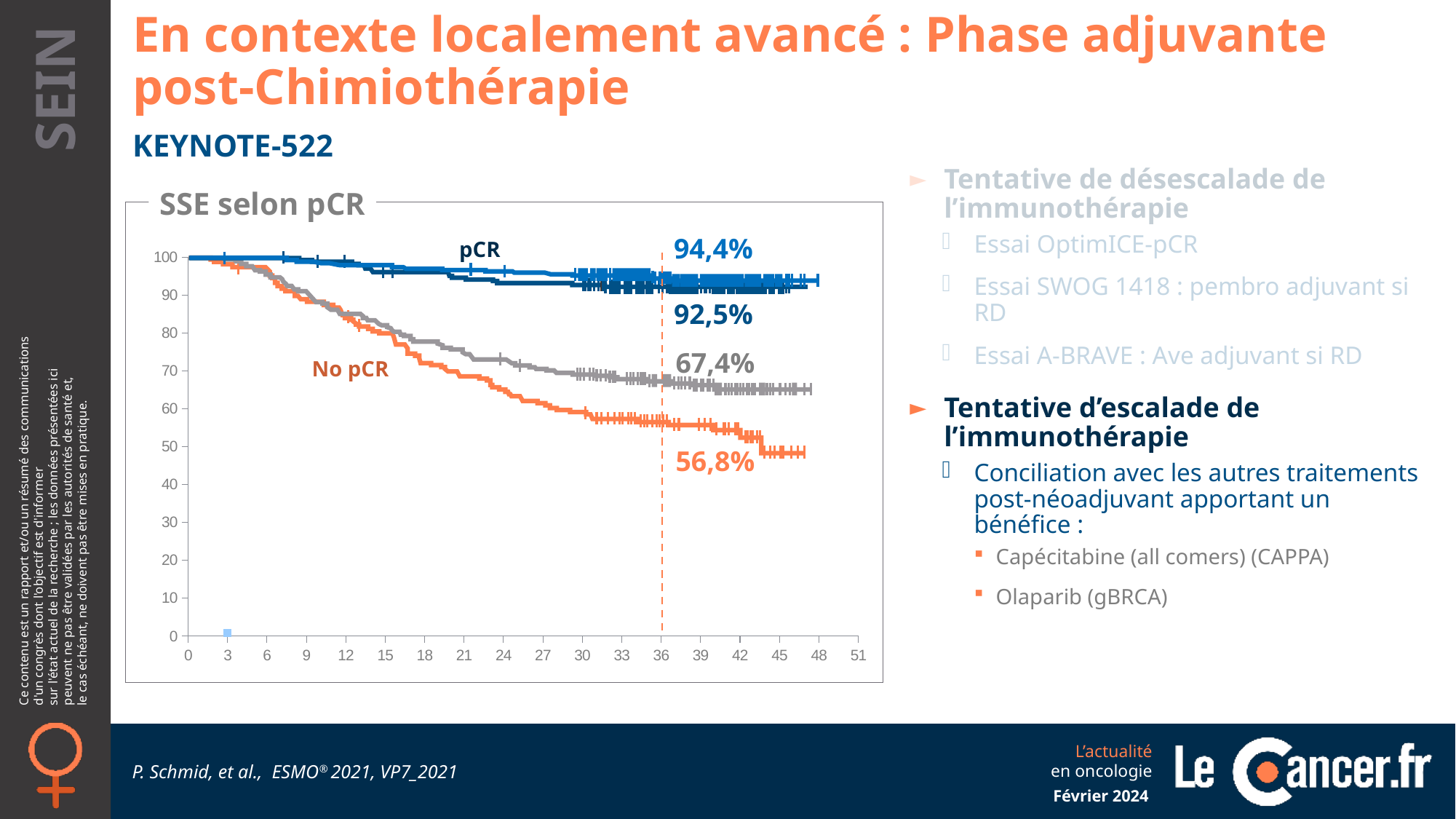
Which is larger at 36 months: the grey curve value or the orange curve value? grey curve (67,4%) What is the title of the chart? SSE selon pCR Is the value of the grey curve at 48 months greater or less than 60? greater What value is printed for the orange (No pCR) curve at 36 months? 56,8% What value is printed for the grey curve at 36 months? 67,4% What is the lowest percentage printed on the chart at the 36-month dashed line? 56,8% What kind of chart is shown on the slide? line chart What is the highest percentage printed on the chart at the 36-month dashed line? 94,4% What is the difference between the two pCR curve values printed at 36 months, 94,4% and 92,5%? 1,9 points How many curves are plotted on the chart? 4 Do the curves rise or fall as time increases along the x axis? fall What is the difference between the highest (94,4%) and lowest (56,8%) values printed at 36 months? 37,6 points